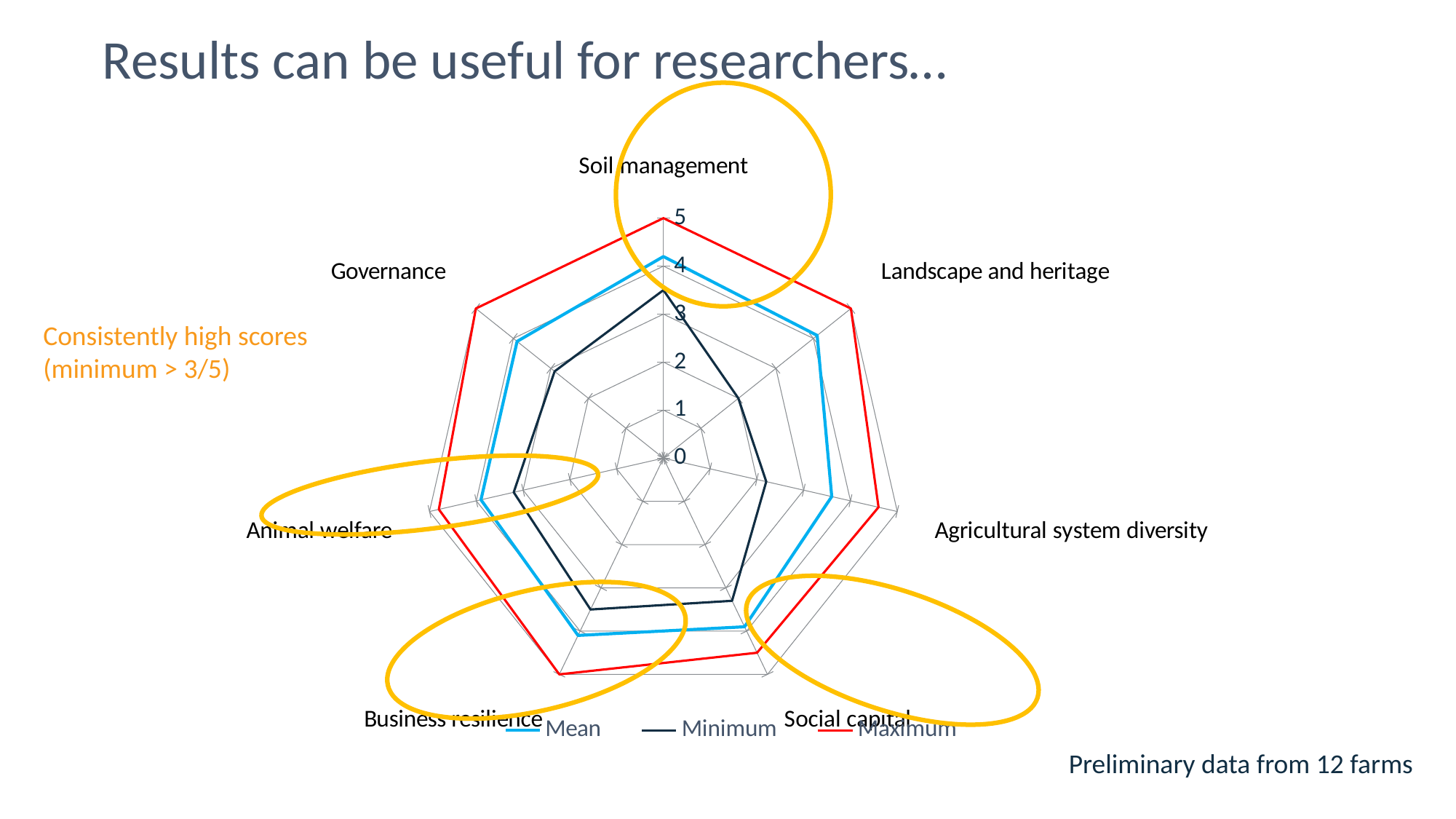
What are the three series named in the legend? Mean, Minimum, Maximum Which is larger for Soil management: the Maximum value or the Minimum value? Maximum How many categories (axes) does the radar chart have? 7 Is the Minimum value for Agricultural system diversity greater or less than 3? less How many series does the legend list? 3 What kind of chart is shown on the slide? Radar chart Is the Mean value for Agricultural system diversity greater or less than 3? greater Is the Minimum value for Soil management greater or less than 3? greater What is the highest value shown on the chart's axis scale? 5 Which is larger: the Minimum value for Soil management or the Minimum value for Landscape and heritage? Soil management